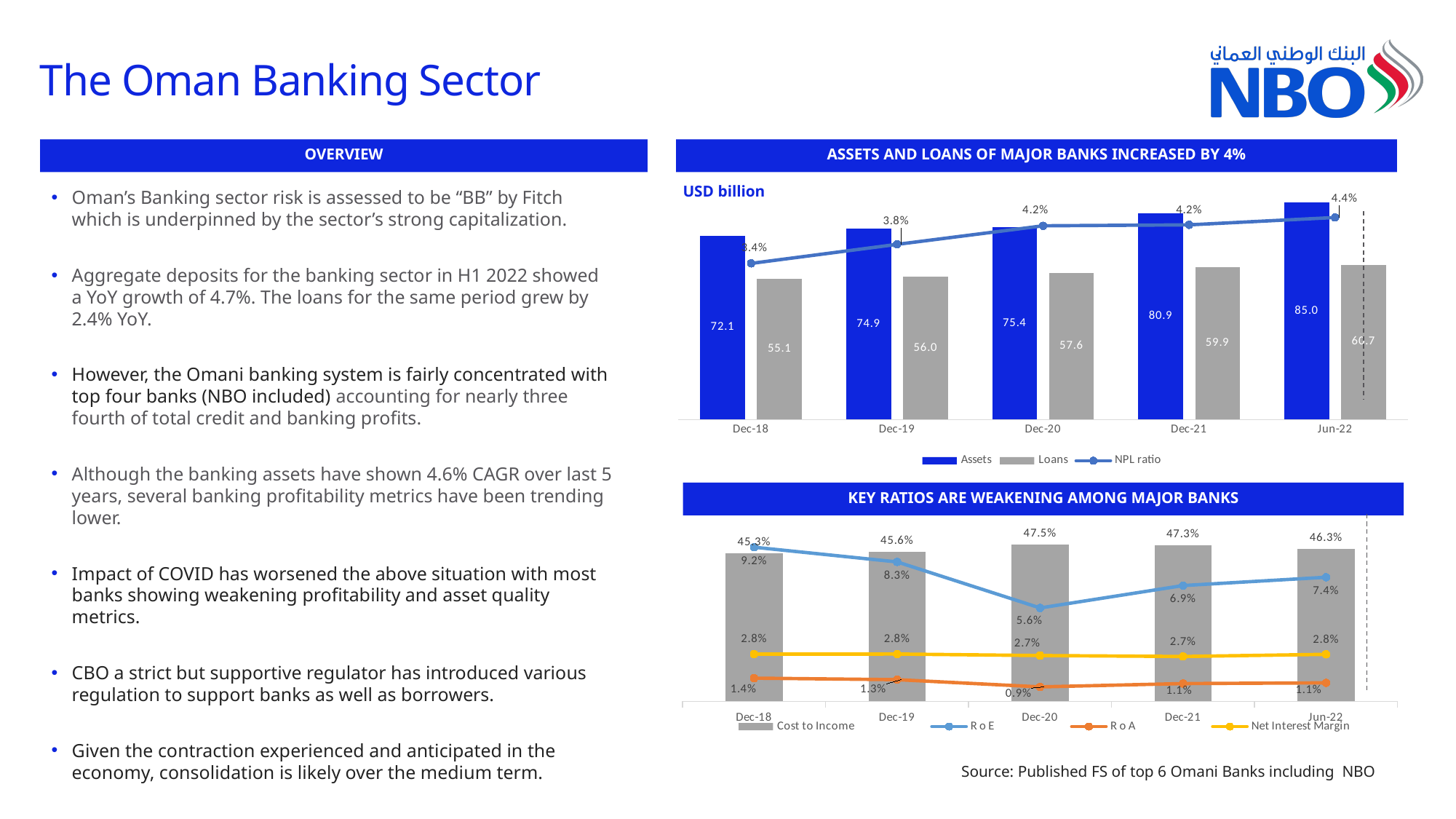
In the 'Assets and loans of major banks' chart, what is the NPL ratio for Jun-22? 4.4% In the 'Assets and loans of major banks' chart, do the Assets values rise or fall from Dec-18 to Jun-22? rise In the 'Key ratios are weakening among major banks' chart, what is the RoE value for Dec-18? 9.2% In the 'Assets and loans of major banks' chart, what is the difference between Assets and Loans in Dec-19? 18.9 In the 'Assets and loans of major banks' chart, how many series does the legend list? 3 In the 'Key ratios are weakening among major banks' chart, is RoE higher in Dec-19 or Jun-22? Dec-19 In the 'Assets and loans of major banks' chart, which period has the highest Assets value? Jun-22 In the 'Assets and loans of major banks' chart, what is the value of Loans for Dec-20? 57.6 In the 'Assets and loans of major banks' chart, what is the value of Assets for Dec-21? 80.9 In the 'Key ratios are weakening among major banks' chart, what is the Cost to Income value for Dec-20? 47.5% In the 'Key ratios are weakening among major banks' chart, which period has the lowest RoE? Dec-20 In the 'Key ratios are weakening among major banks' chart, how many periods are shown on the x axis? 5